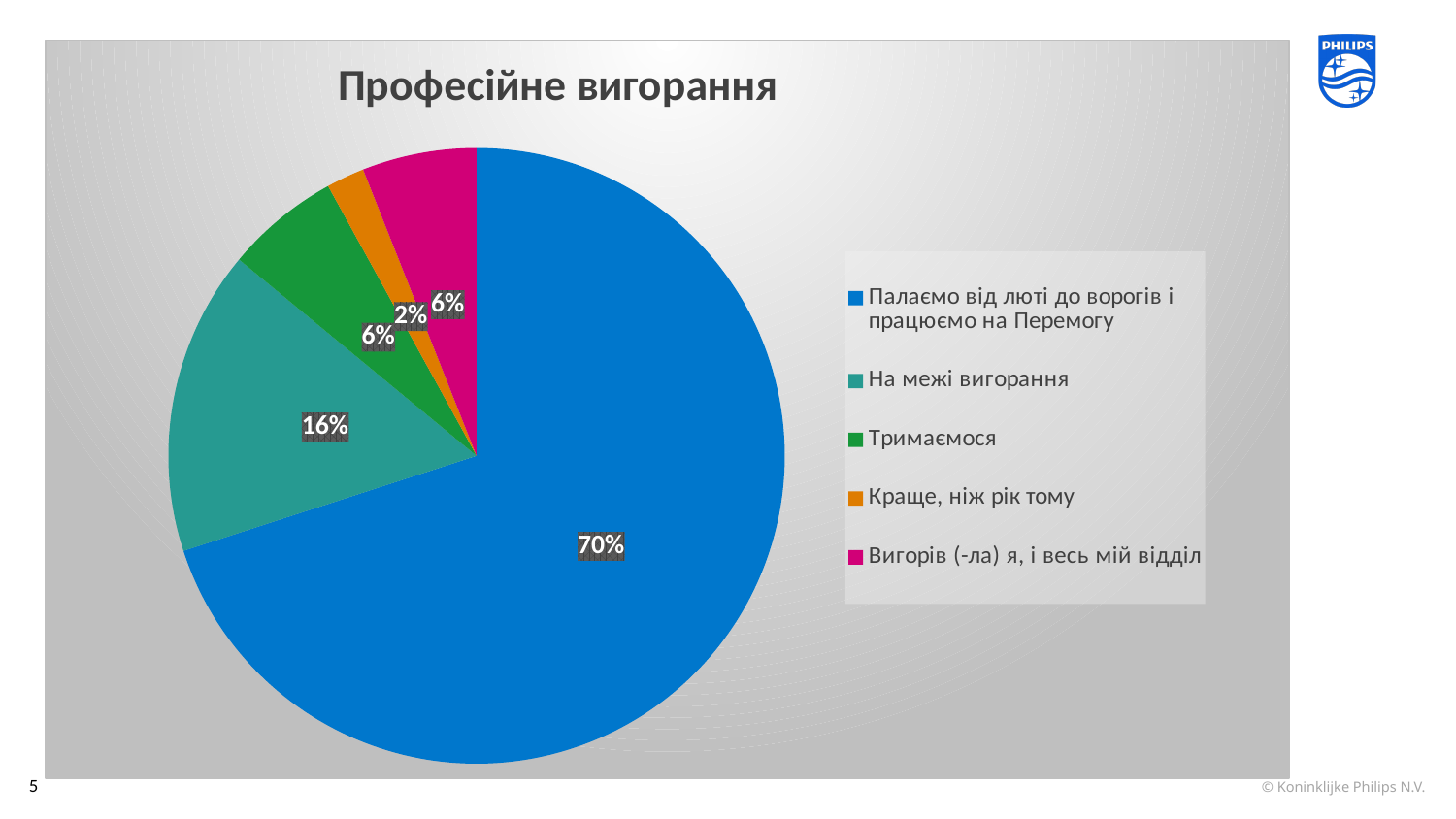
Which category has the smallest share of the pie? Краще, ніж рік тому What kind of chart is shown on the slide? pie chart What is the value for "Краще, ніж рік тому"? 2% Which category has the largest share of the pie? Палаємо від люті до ворогів і працюємо на Перемогу What share of the pie is labelled "Палаємо від люті до ворогів і працюємо на Перемогу"? 70% What is the value for "На межі вигорання"? 16% What is the value for "Вигорів (-ла) я, і весь мій відділ"? 6% What is the value for "Тримаємося"? 6% How many slices does the pie chart have? 5 What is the difference in percentage points between "Палаємо від люті до ворогів і працюємо на Перемогу" and "На межі вигорання"? 54 percentage points What is the title of the chart? Професійне вигорання Which is larger, the share for "На межі вигорання" or the share for "Тримаємося"? На межі вигорання